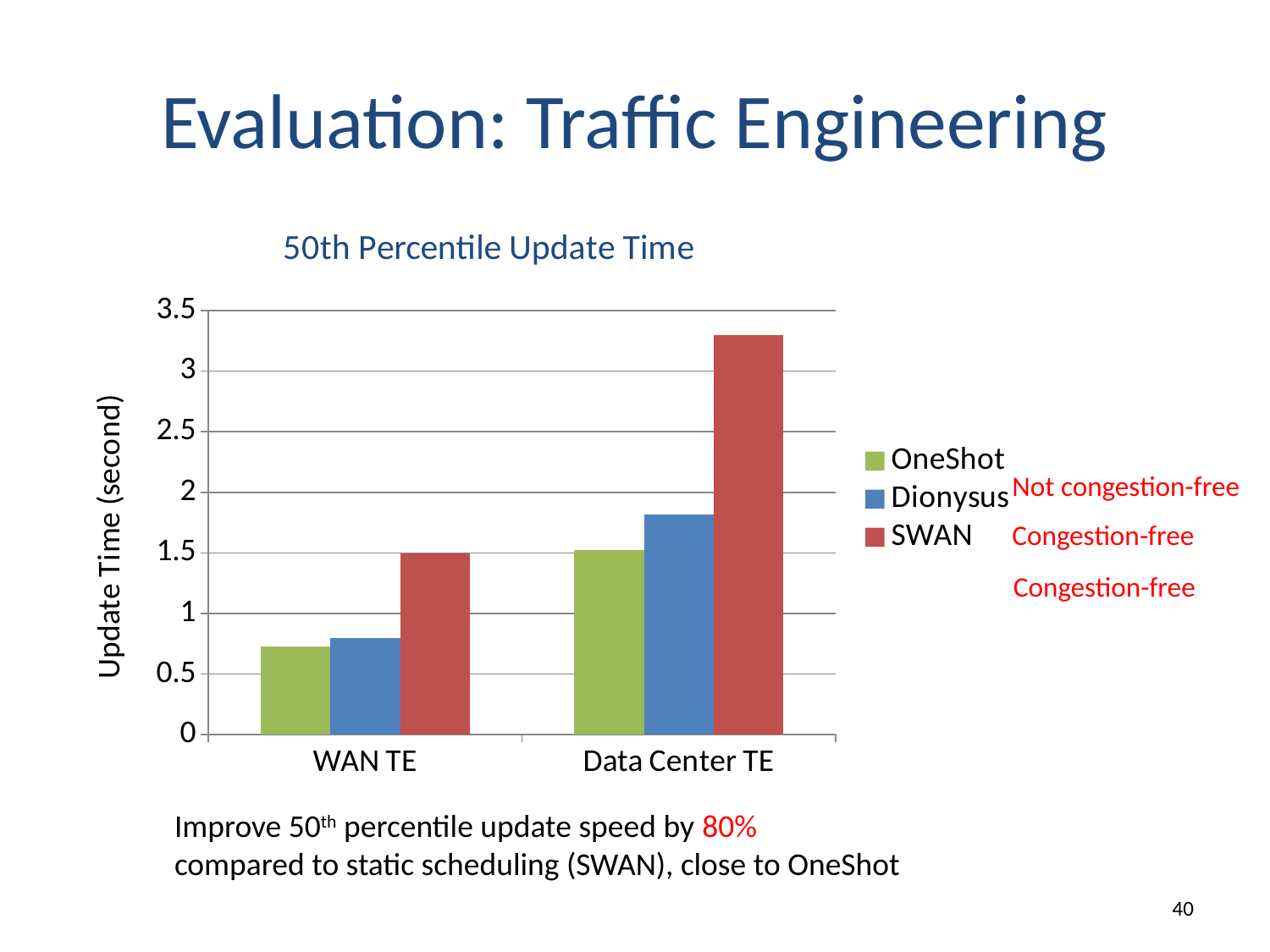
What type of chart is shown on the slide? bar chart Which series has the lowest update time for WAN TE? OneShot Is the Dionysus value for WAN TE greater or less than 1? less What is the label of the y axis? Update Time (second) Which is larger: the SWAN value for WAN TE or the SWAN value for Data Center TE? Data Center TE How many categories are shown on the x axis of the chart? 2 Which is larger: the OneShot value for Data Center TE or the Dionysus value for WAN TE? OneShot value for Data Center TE What is the title of the chart? 50th Percentile Update Time Which series has the highest update time for Data Center TE? SWAN Is the Dionysus value for Data Center TE greater or less than 1.5? greater Is the SWAN value for Data Center TE greater or less than 3? greater How many series does the chart legend list? 3